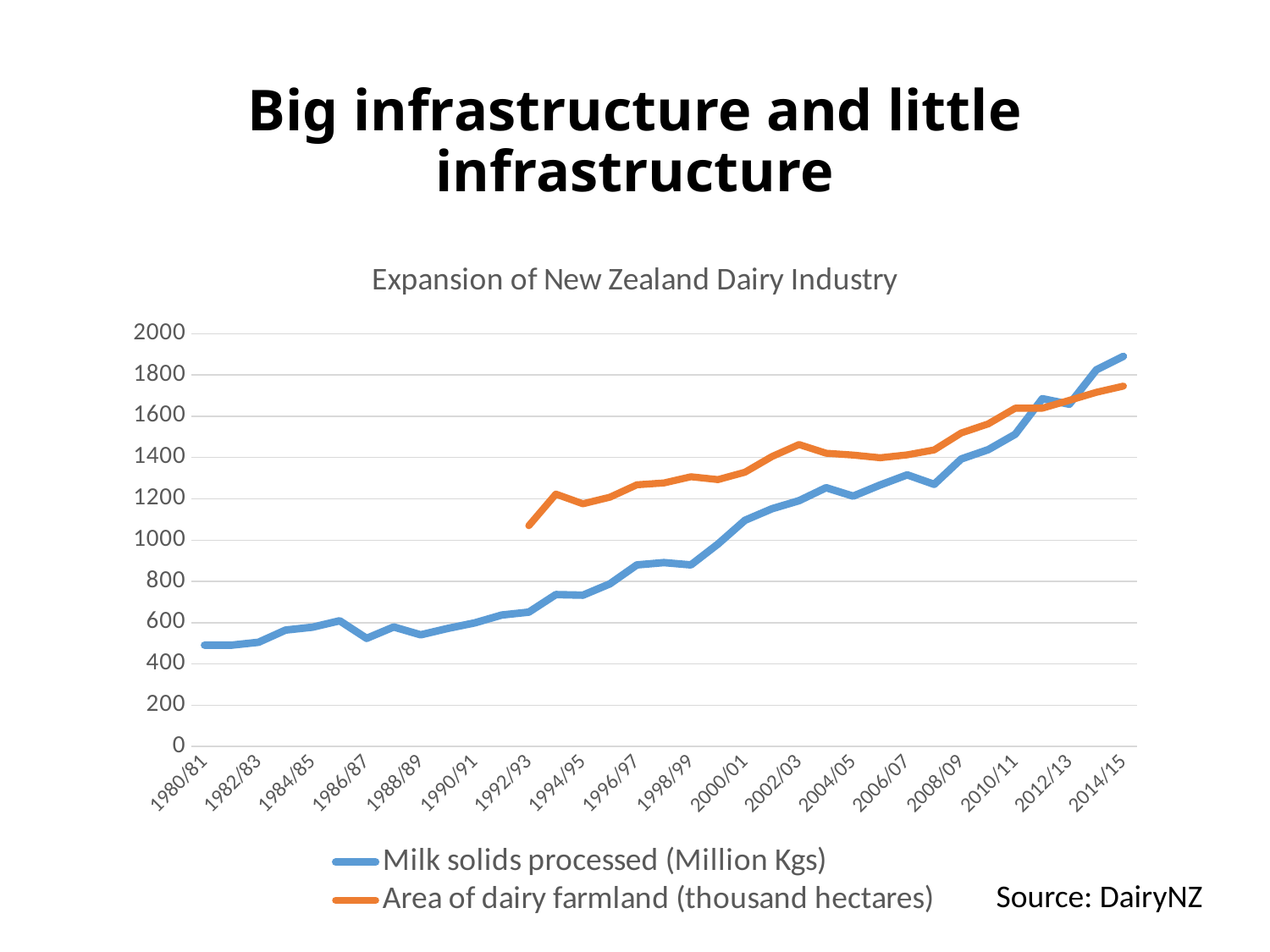
What is the title of the chart? Expansion of New Zealand Dairy Industry Is the value for Milk solids processed in 1980/81 greater or less than 600? less How many series does the legend list? 2 Is the value for Area of dairy farmland in 2014/15 greater or less than 1600? greater Is the value for Milk solids processed in 1996/97 greater or less than 800? greater What kind of chart is shown on the slide? Line chart Does the Milk solids processed series generally rise or fall from 1980/81 to 2014/15? Rise In 2014/15, which series has the higher value: Milk solids processed or Area of dairy farmland? Milk solids processed In 2002/03, which series has the higher value: Milk solids processed or Area of dairy farmland? Area of dairy farmland Which series is drawn in orange? Area of dairy farmland (thousand hectares)